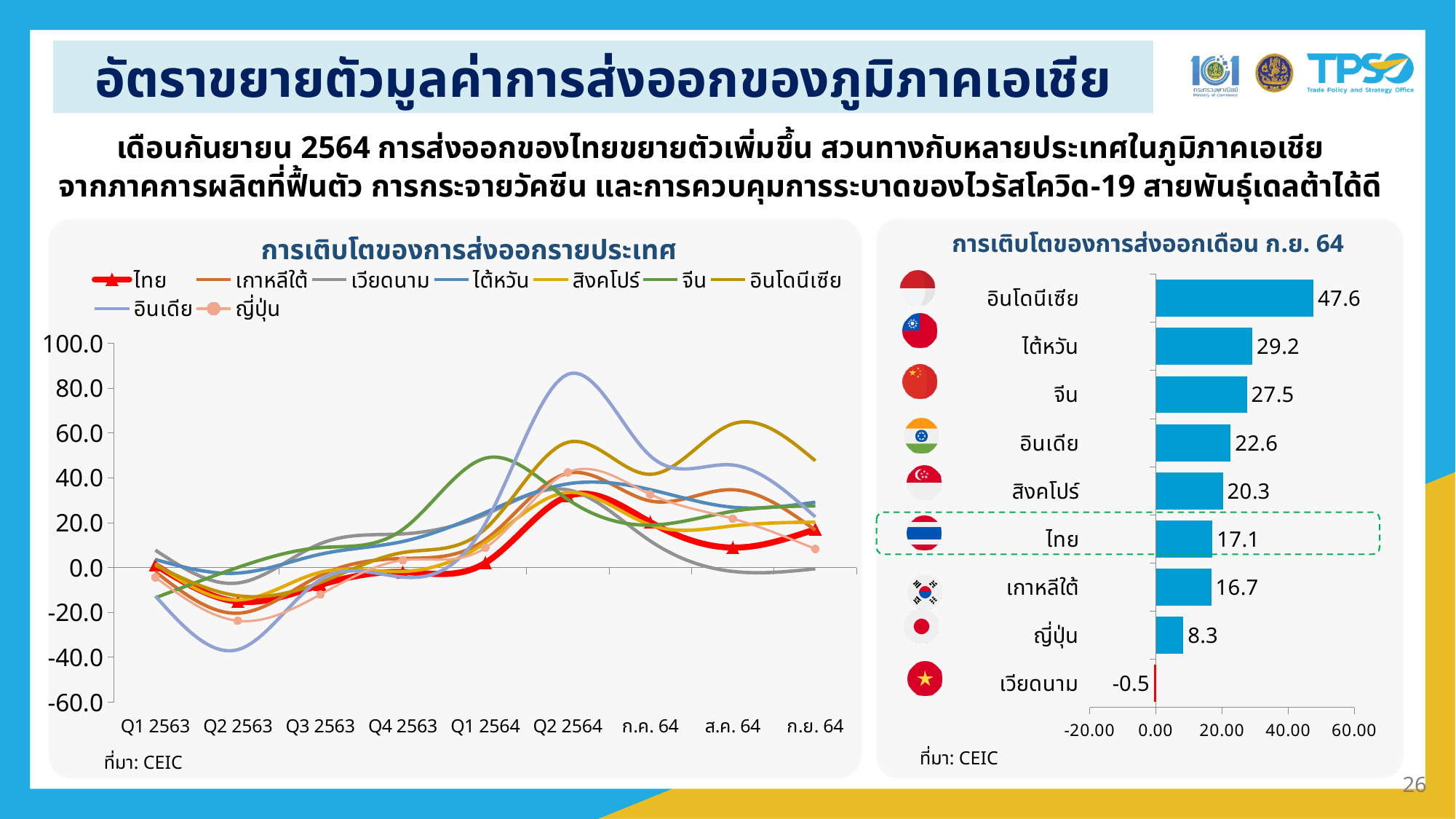
In the chart titled การเติบโตของการส่งออกเดือน ก.ย. 64, which country has the highest value? อินโดนีเซีย In the chart titled การเติบโตของการส่งออกรายประเทศ, is the value for อินเดีย at Q2 2564 greater or less than 80? greater In the chart titled การเติบโตของการส่งออกเดือน ก.ย. 64, what is the value for อินโดนีเซีย? 47.6 In the chart titled การเติบโตของการส่งออกรายประเทศ, does the value for ไทย rise or fall from Q1 2564 to Q2 2564? rise In the chart titled การเติบโตของการส่งออกรายประเทศ, is the value for ไทย at Q2 2563 greater or less than 0? less In the chart titled การเติบโตของการส่งออกเดือน ก.ย. 64, which country has the lowest value? เวียดนาม In the chart titled การเติบโตของการส่งออกเดือน ก.ย. 64, what is the difference between the values for ไต้หวัน and จีน? 1.7 In the chart titled การเติบโตของการส่งออกเดือน ก.ย. 64, how many countries are shown? 9 In the chart titled การเติบโตของการส่งออกรายประเทศ, how many series does the legend list? 9 What kind of chart is the chart titled การเติบโตของการส่งออกเดือน ก.ย. 64? bar chart In the chart titled การเติบโตของการส่งออกเดือน ก.ย. 64, what is the value for ไทย? 17.1 In the chart titled การเติบโตของการส่งออกเดือน ก.ย. 64, which is larger, the value for สิงคโปร์ or the value for ญี่ปุ่น? สิงคโปร์